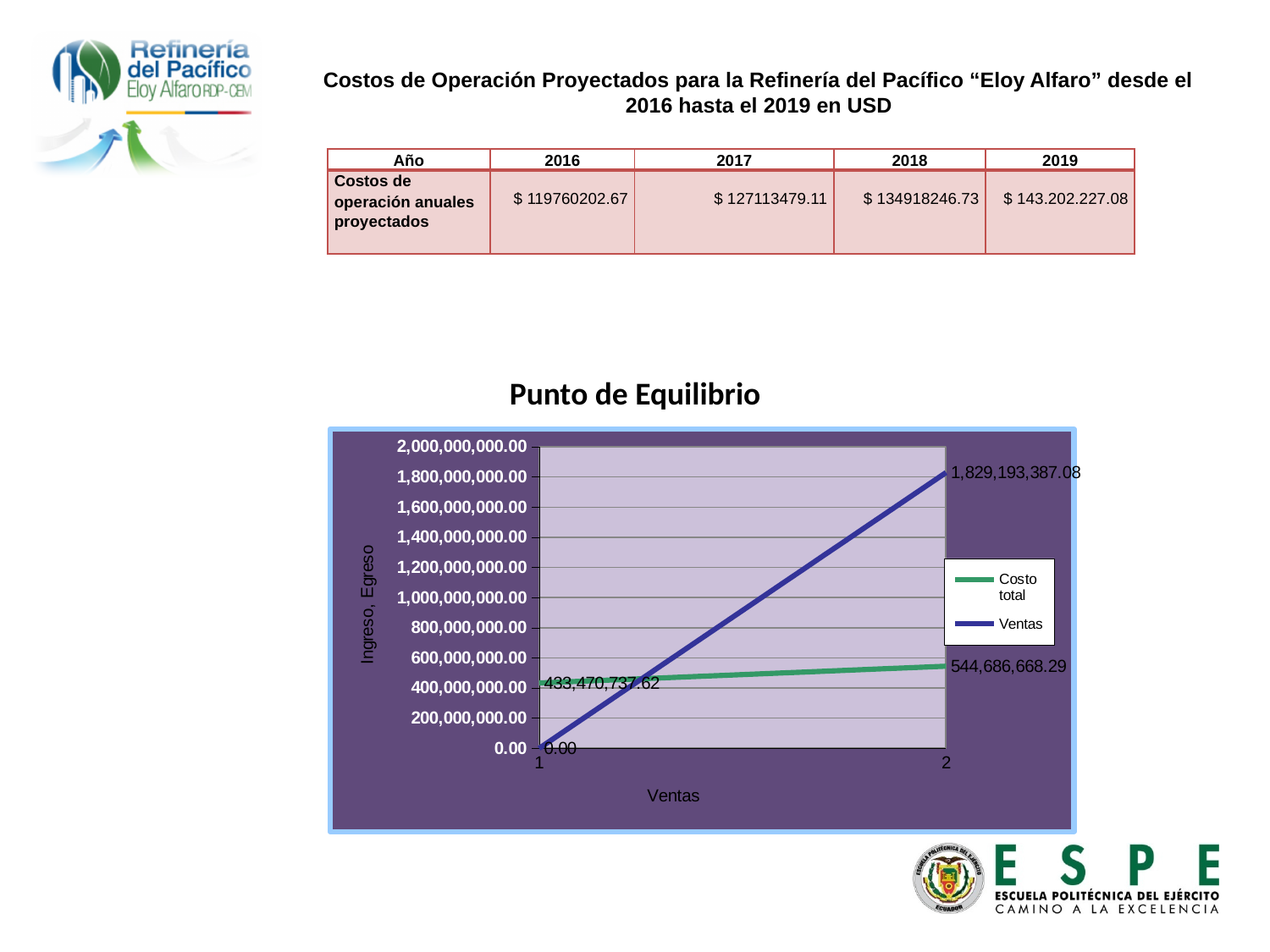
In the "Punto de Equilibrio" chart, what is the value of Ventas at point 1? 0.00 In the "Punto de Equilibrio" chart, what is the value of Costo total at point 2? 544,686,668.29 In the "Punto de Equilibrio" chart, what is the value of Costo total at point 1? 433,470,737.62 What type of chart is shown under the title "Punto de Equilibrio"? line chart In the "Punto de Equilibrio" chart, which series has the higher value at point 2, Costo total or Ventas? Ventas In the "Punto de Equilibrio" chart, what is the difference between Ventas and Costo total at point 2? 1,284,506,718.79 In the "Punto de Equilibrio" chart, what is the value of Ventas at point 2? 1,829,193,387.08 In the "Punto de Equilibrio" chart, what is the label of the y axis? Ingreso, Egreso In the "Punto de Equilibrio" chart, which series has the higher value at point 1, Costo total or Ventas? Costo total How many series does the legend of the "Punto de Equilibrio" chart list? 2 In the "Punto de Equilibrio" chart, by how much does Costo total increase from point 1 to point 2? 111,215,930.67 In the "Punto de Equilibrio" chart, does the Ventas series rise or fall from point 1 to point 2? rise